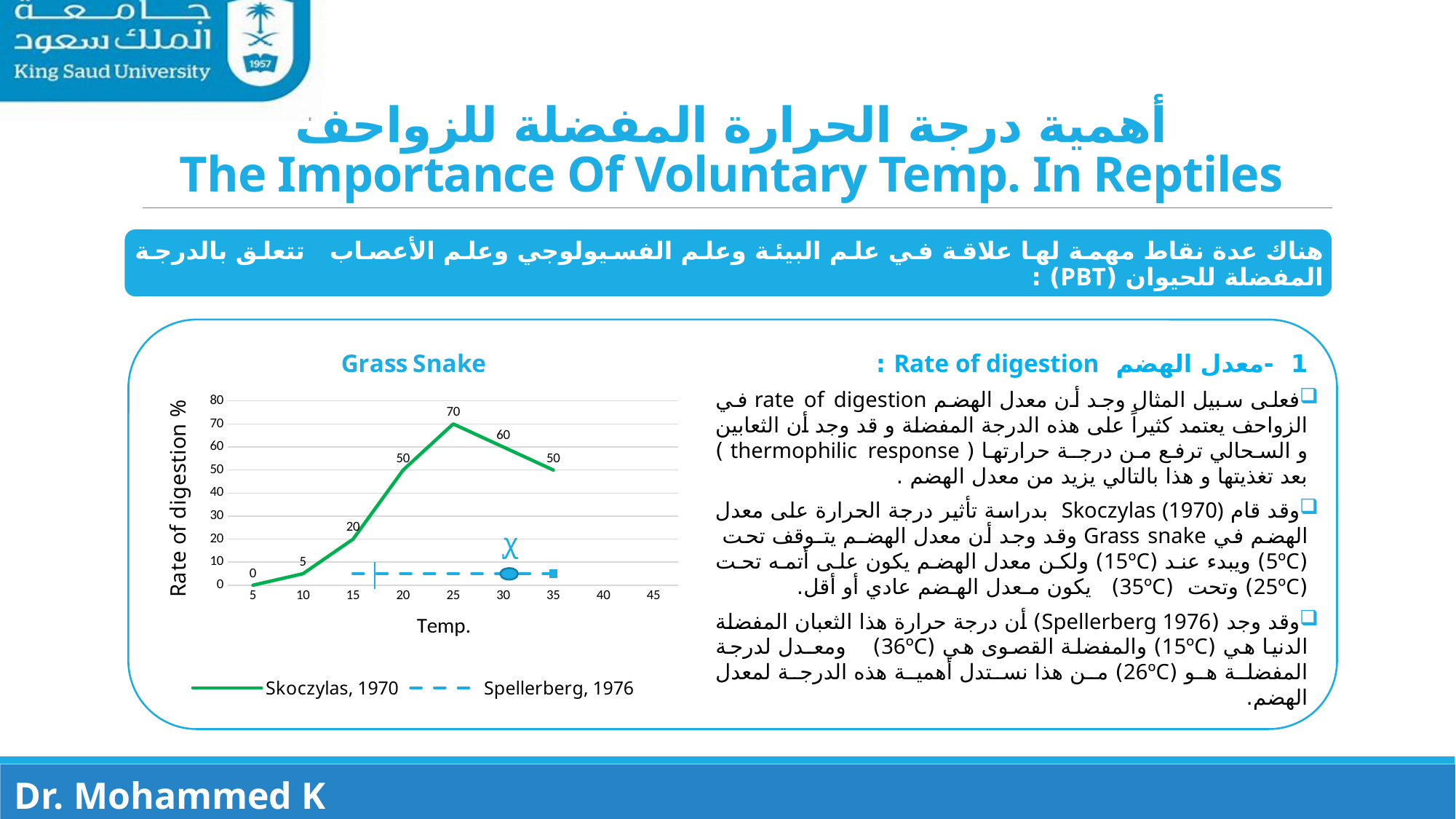
What is the rate of digestion for the Skoczylas, 1970 series at a temperature of 35? 50 What is the difference between the Skoczylas, 1970 values at temperatures 25 and 30? 10 How many labelled data points does the Skoczylas, 1970 series have? 7 Does the Skoczylas, 1970 series rise or fall between temperatures 25 and 35? fall How many series does the chart legend list? 2 What is the title of the chart? Grass Snake What is the rate of digestion for the Skoczylas, 1970 series at a temperature of 25? 70 At which temperature is the Skoczylas, 1970 series at its lowest rate of digestion? 5 For the Skoczylas, 1970 series, which temperature has the larger rate of digestion, 20 or 30? 30 What is the rate of digestion for the Skoczylas, 1970 series at a temperature of 15? 20 What type of chart is shown on the slide? line chart At which temperature does the Skoczylas, 1970 series reach its highest rate of digestion? 25